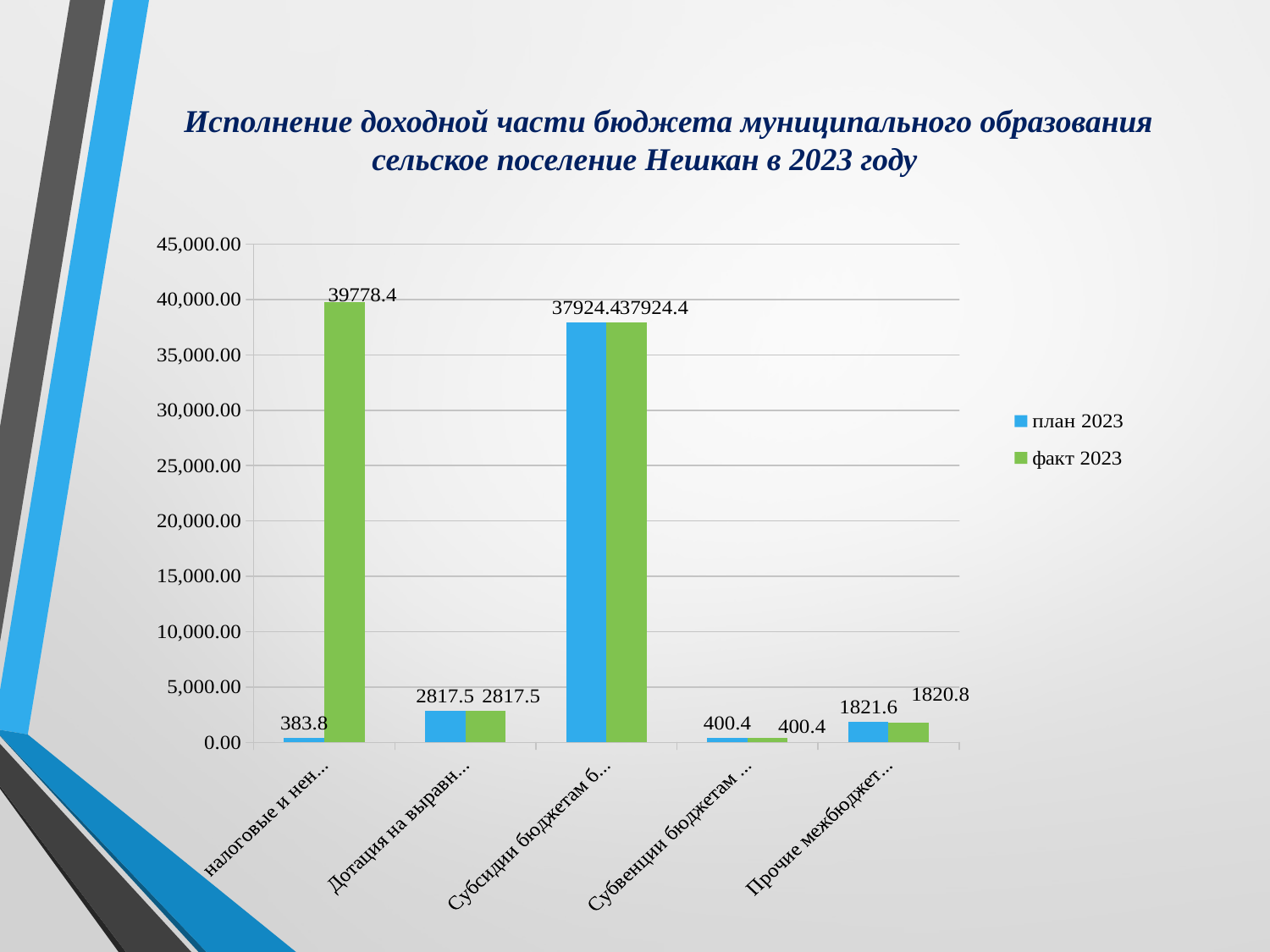
Which category has the lowest план 2023 value? налоговые и нен... How many series does the legend list? 2 How many categories are shown on the x axis? 5 What is the value of план 2023 for the category "Субсидии бюджетам б..."? 37924.4 What is the value of факт 2023 for the category "налоговые и нен..."? 39778.4 What kind of chart is shown on the slide? bar chart What is the difference between факт 2023 and план 2023 for the category "налоговые и нен..."? 39394.6 Which series is shown in green in the legend? факт 2023 What is the value of план 2023 for the category "налоговые и нен..."? 383.8 What is the value of факт 2023 for the category "Прочие межбюджет..."? 1820.8 Which is larger for the category "Прочие межбюджет...": план 2023 or факт 2023? план 2023 Which category has the highest факт 2023 value? налоговые и нен...